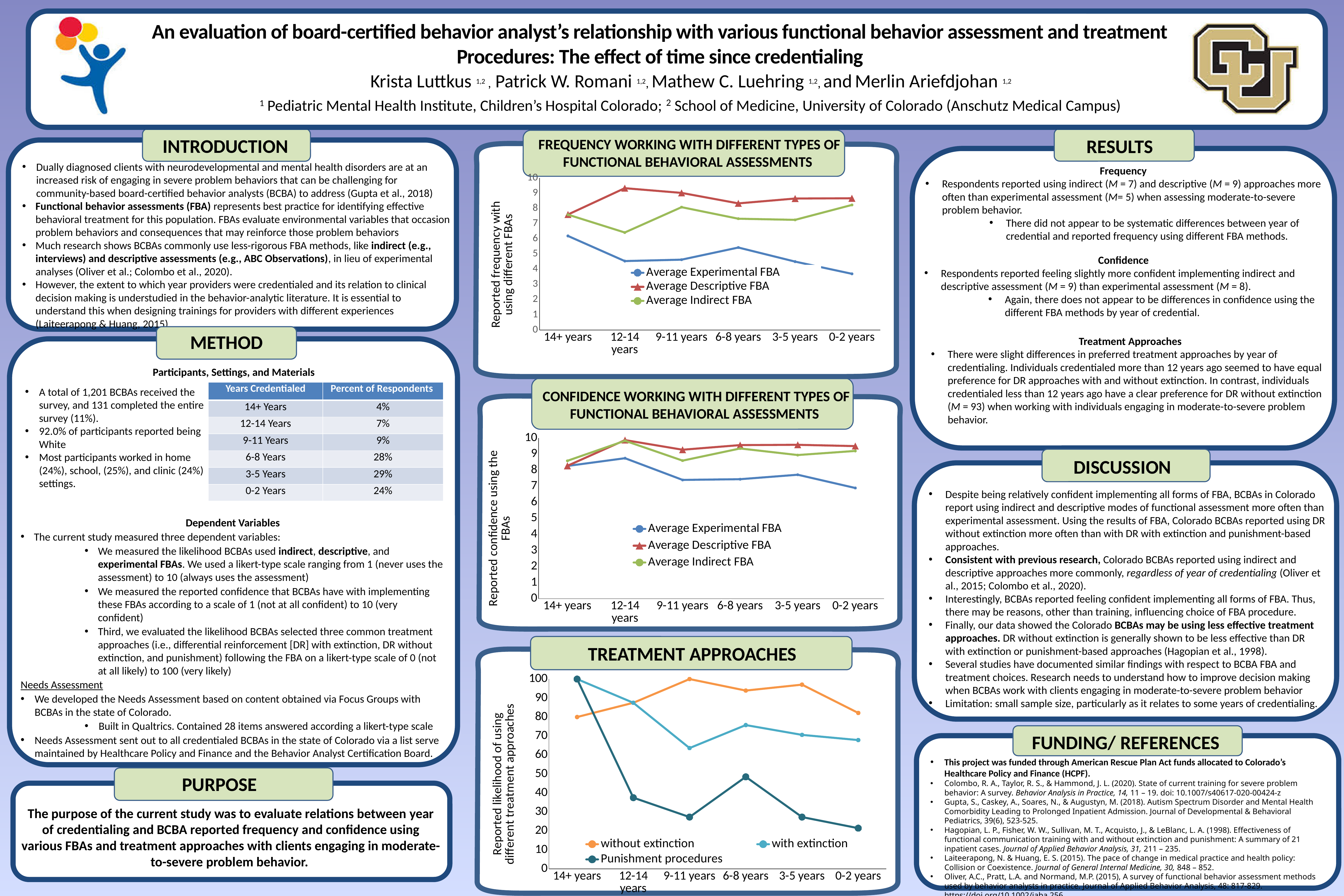
In the 'Frequency working with different types of functional behavioral assessments' chart, which series has the highest value at 12-14 years? Average Descriptive FBA In the 'Frequency working with different types of functional behavioral assessments' chart, how many series does the legend list? 3 In the 'Treatment approaches' chart, which series has the highest value at 9-11 years? without extinction What kind of chart is the 'Frequency working with different types of functional behavioral assessments' chart? line chart In the 'Confidence working with different types of functional behavioral assessments' chart, which series has the lowest value at 9-11 years? Average Experimental FBA In the 'Frequency working with different types of functional behavioral assessments' chart, how many year-credentialed categories are shown on the x axis? 6 In the 'Treatment approaches' chart, is the value for Punishment procedures at 14+ years greater or less than 90? greater In the 'Frequency working with different types of functional behavioral assessments' chart, is the value for Average Experimental FBA at 14+ years greater or less than 5? greater In the 'Confidence working with different types of functional behavioral assessments' chart, is the value for Average Experimental FBA at 0-2 years greater or less than 8? less In the 'Treatment approaches' chart, does the Punishment procedures line rise or fall from 14+ years to 12-14 years? fall In the 'Frequency working with different types of functional behavioral assessments' chart, at 12-14 years, which is larger: Average Descriptive FBA or Average Experimental FBA? Average Descriptive FBA In the 'Treatment approaches' chart, how many series does the legend list? 3